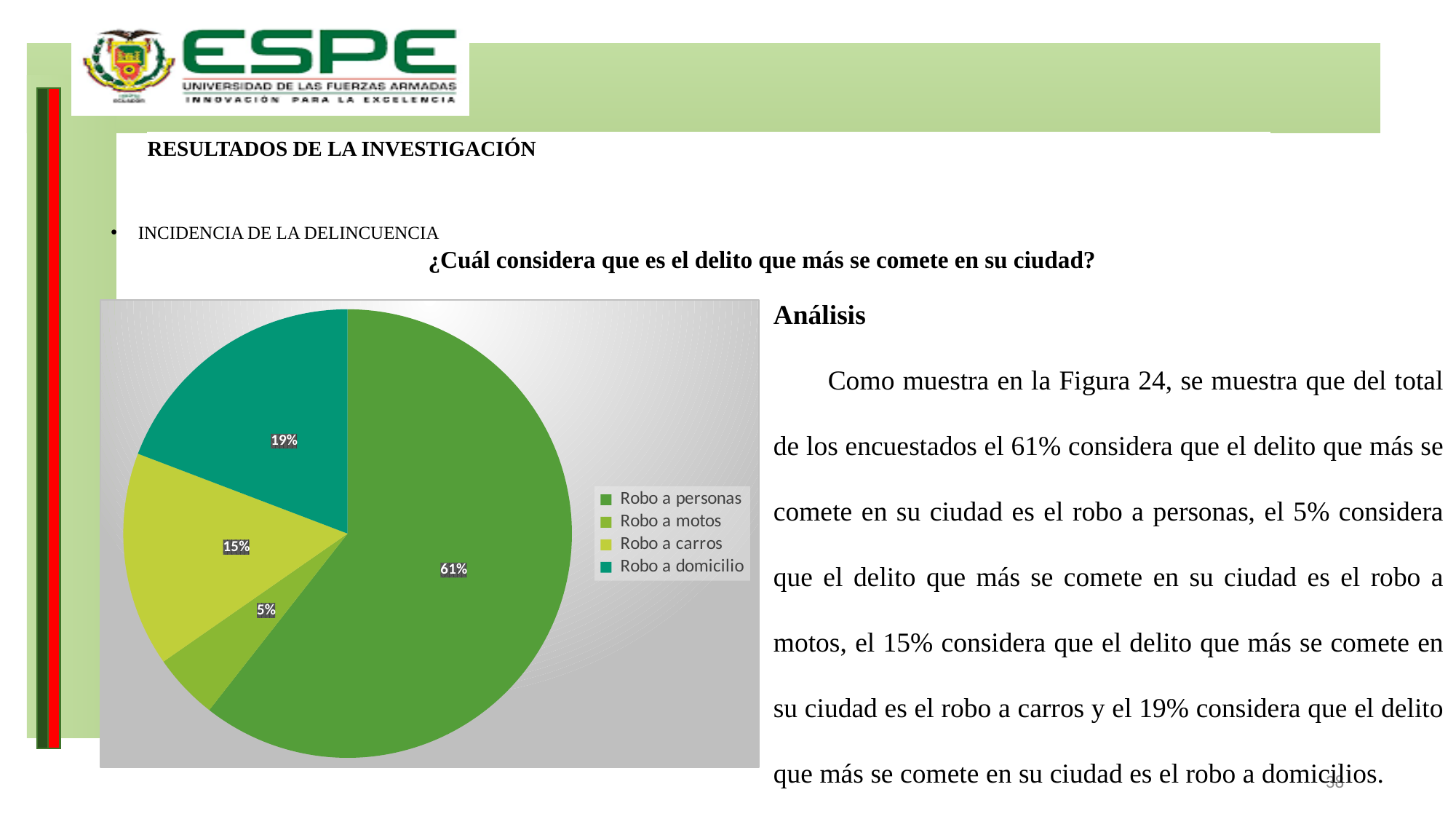
Which category has the largest slice of the pie? Robo a personas How many categories does the pie chart show? 4 Which is larger, the share for 'Robo a carros' or the share for 'Robo a domicilio'? Robo a domicilio What percentage of respondents consider 'Robo a personas' the most committed crime? 61% What percentage is shown for 'Robo a domicilio'? 19% Which legend entry is shown in the darkest teal colour? Robo a domicilio What percentage is shown for 'Robo a carros'? 15% What percentage is shown for 'Robo a motos'? 5% What is the difference in percentage points between 'Robo a personas' and 'Robo a domicilio'? 42 What is the combined share of 'Robo a carros' and 'Robo a motos'? 20% What kind of chart is shown on the slide? Pie chart Which category has the smallest slice of the pie? Robo a motos